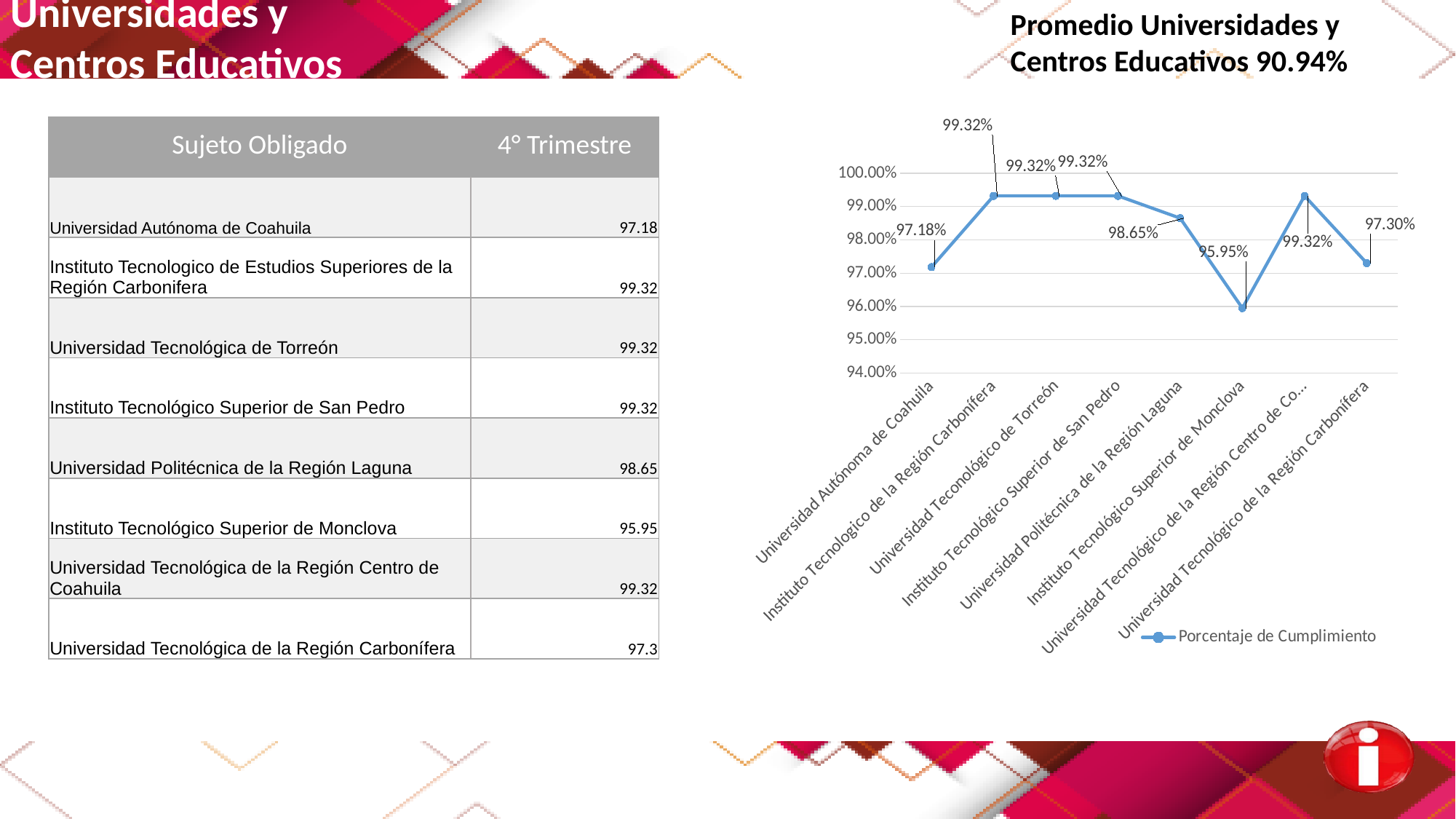
What is the value for Universidad Autónoma de Coahuila in the chart? 97.18% What is the value for Instituto Tecnológico Superior de Monclova in the chart? 95.95% What is the difference between the value for Universidad Tecnológico de Torreón and the value for Instituto Tecnológico Superior de Monclova? 3.37% Is the value for Universidad Autónoma de Coahuila greater or less than 98.00%? less How many series does the chart legend list? 1 How many categories are plotted on the x axis of the chart? 8 Which is larger: the value for Universidad Autónoma de Coahuila or the value for Universidad Politécnica de la Región Laguna? Universidad Politécnica de la Región Laguna What is the name of the series shown in the chart legend? Porcentaje de Cumplimiento What type of chart is shown on the slide? line chart What is the value for Universidad Tecnológico de la Región Carbonífera in the chart? 97.30% What is the value for Universidad Politécnica de la Región Laguna in the chart? 98.65% Which category has the lowest value in the chart? Instituto Tecnológico Superior de Monclova